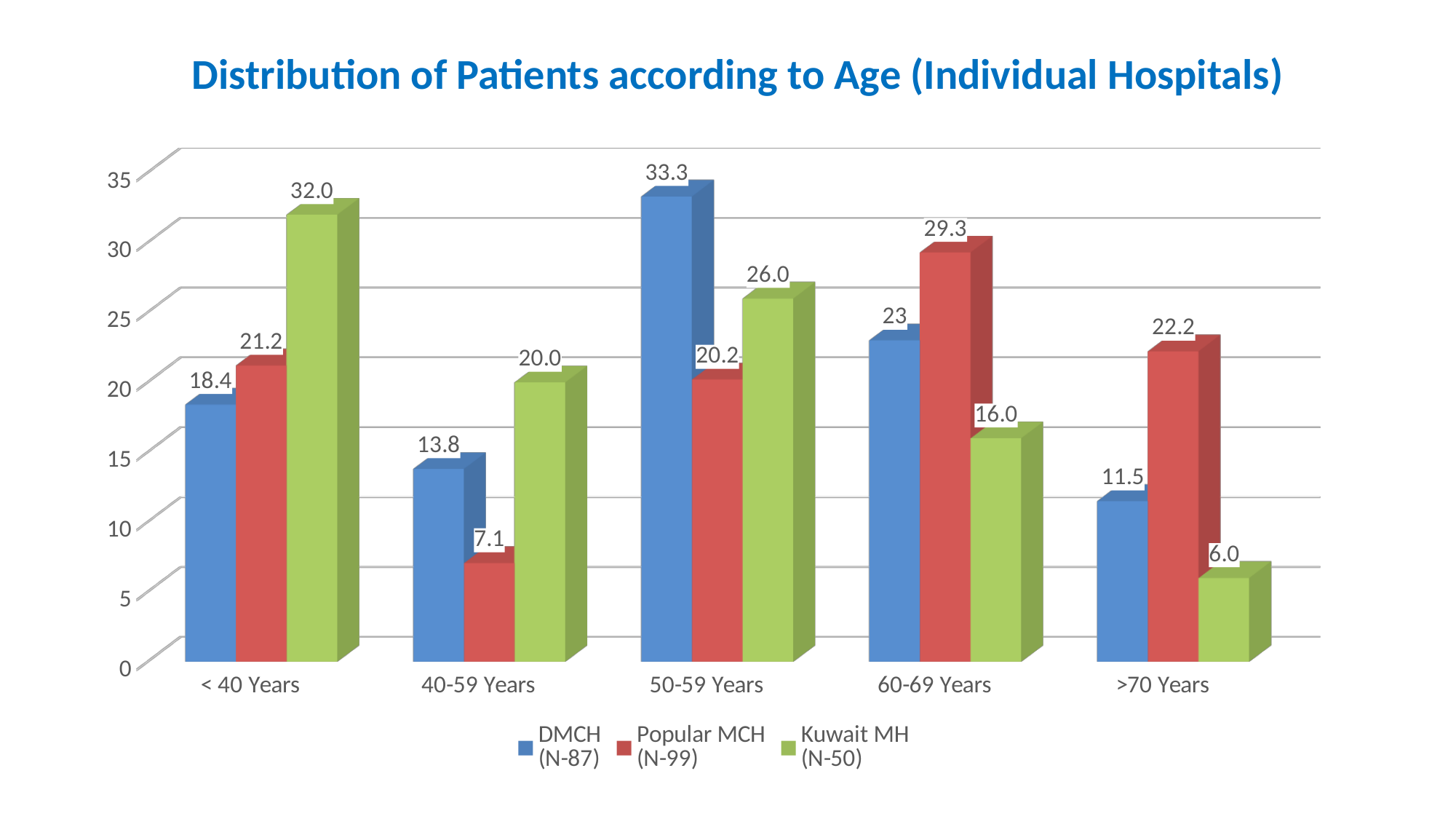
How many series does the legend list? 3 What is the title of the chart? Distribution of Patients according to Age (Individual Hospitals) What is the value for Popular MCH (N-99) in the >70 Years category? 22.2 What is the value for Kuwait MH (N-50) in the < 40 Years category? 32.0 What is the difference between the Popular MCH (N-99) and Kuwait MH (N-50) values in the 60-69 Years category? 13.3 What is the value for DMCH (N-87) in the 50-59 Years category? 33.3 Which age category has the lowest value for Kuwait MH (N-50)? >70 Years What is the value for Popular MCH (N-99) in the 40-59 Years category? 7.1 Which is larger in the 50-59 Years category: the DMCH (N-87) value or the Kuwait MH (N-50) value? DMCH (N-87) Which age category has the highest value for DMCH (N-87)? 50-59 Years What kind of chart is shown on the slide? Bar chart How many age categories are shown on the x axis? 5